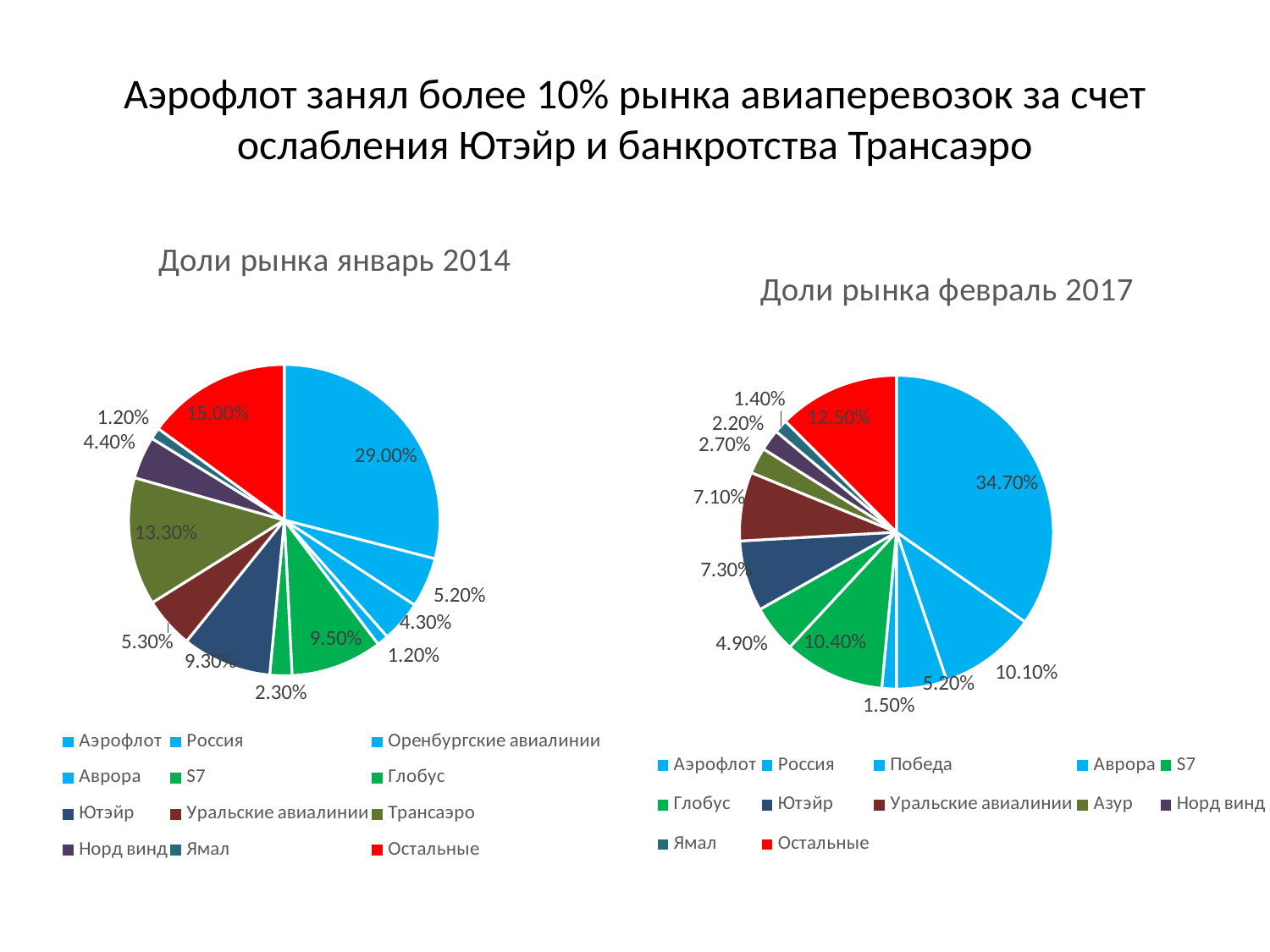
In the chart 'Доли рынка февраль 2017', what is the share for Ютэйр? 7.30% In the chart 'Доли рынка февраль 2017', what is the share for Остальные? 12.50% Which category appears in the legend of 'Доли рынка январь 2014' but not in the legend of 'Доли рынка февраль 2017'? Трансаэро and Оренбургские авиалинии How many categories does the legend of the chart 'Доли рынка февраль 2017' list? 12 In the chart 'Доли рынка январь 2014', which category has the largest share? Аэрофлот In the chart 'Доли рынка январь 2014', what is the share for Аэрофлот? 29.00% In the chart 'Доли рынка январь 2014', which is larger: the share for S7 or the share for Ютэйр? S7 In the chart 'Доли рынка февраль 2017', what is the share for Аэрофлот? 34.70% In the chart 'Доли рынка февраль 2017', which category has the smallest share? Ямал In the chart 'Доли рынка январь 2014', what is the share for Трансаэро? 13.30% What kind of charts are shown on the slide? Pie charts What is the difference between the Аэрофлот share in 'Доли рынка февраль 2017' and in 'Доли рынка январь 2014'? 5.70%